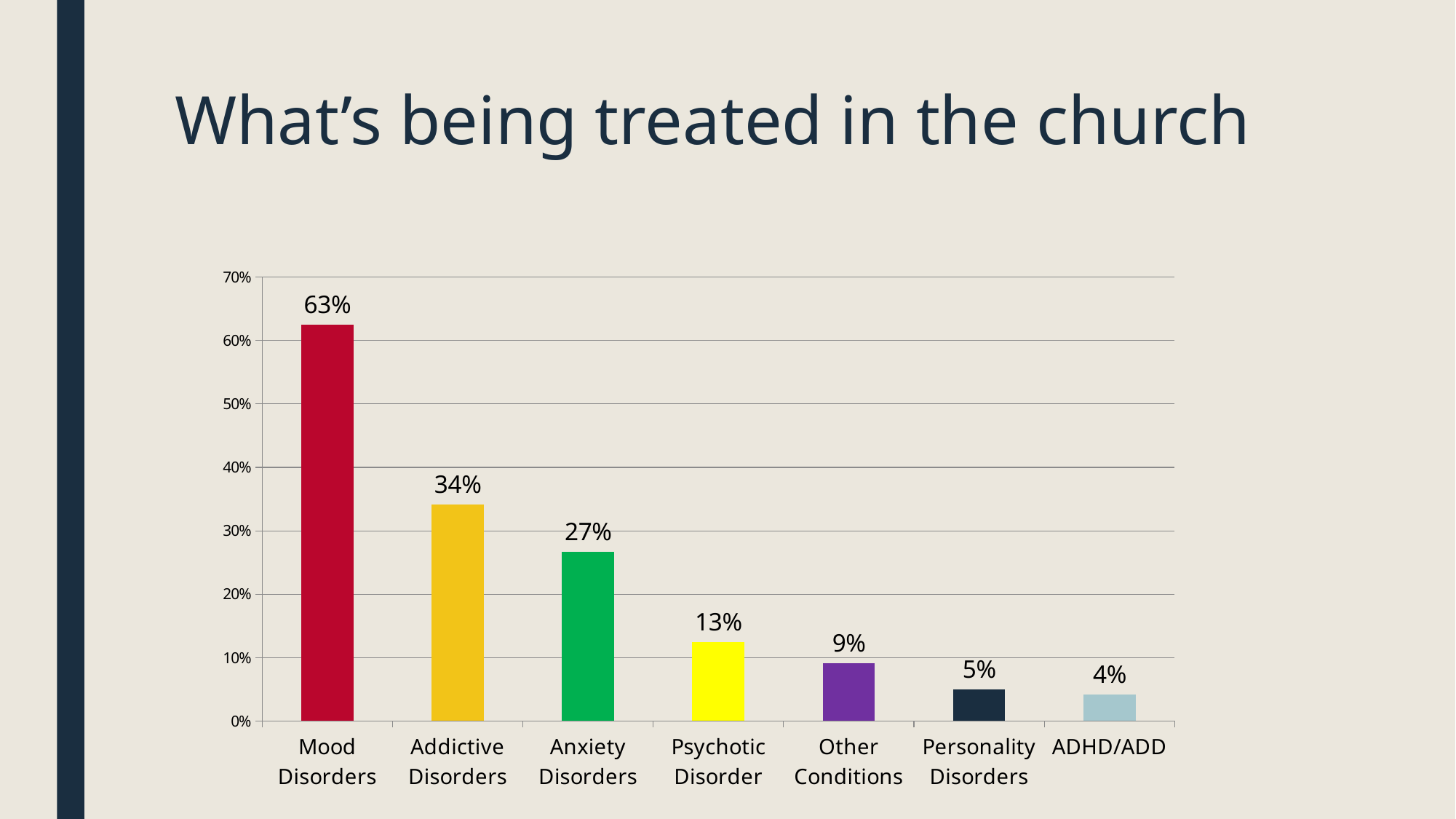
Which is larger, the value for Addictive Disorders or the value for Anxiety Disorders? Addictive Disorders What is the value for Other Conditions? 9% How many categories are shown on the x axis? 7 What is the value for Mood Disorders? 63% What is the title of the slide? What's being treated in the church Is the value for Anxiety Disorders greater or less than 30%? less Which category has the lowest value? ADHD/ADD What is the difference between the values for Psychotic Disorder and Personality Disorders? 8% What is the value for Anxiety Disorders? 27% What is the difference between the values for Mood Disorders and Addictive Disorders? 29% Which category has the highest value? Mood Disorders What kind of chart is shown on the slide? bar chart